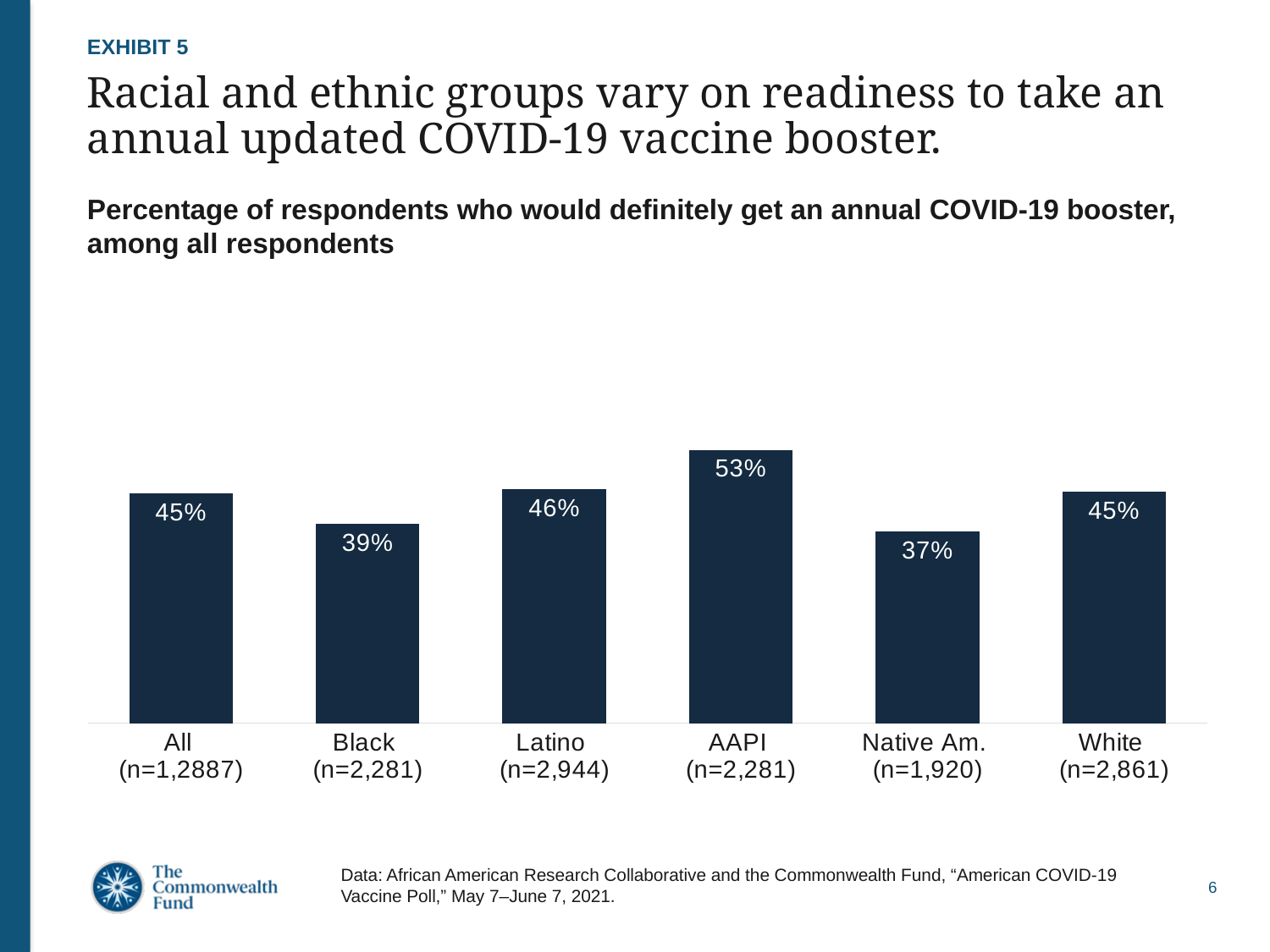
What type of chart is shown on the slide? Bar chart What is the value shown for Latino respondents? 46% What is the value shown for Black respondents? 39% Which group has the highest percentage who would definitely get an annual booster? AAPI What percentage of AAPI respondents would definitely get an annual COVID-19 booster? 53% What is the sample size (n) shown for the Latino group? 2,944 What is the difference in percentage points between Latino and Black respondents? 7 Which is larger, the value for Black respondents or the value for White respondents? White How many groups are shown on the chart? 6 Which group has the lowest percentage who would definitely get an annual booster? Native Am. What is the value shown for Native Am. respondents? 37% What is the difference in percentage points between AAPI and Native Am. respondents? 16